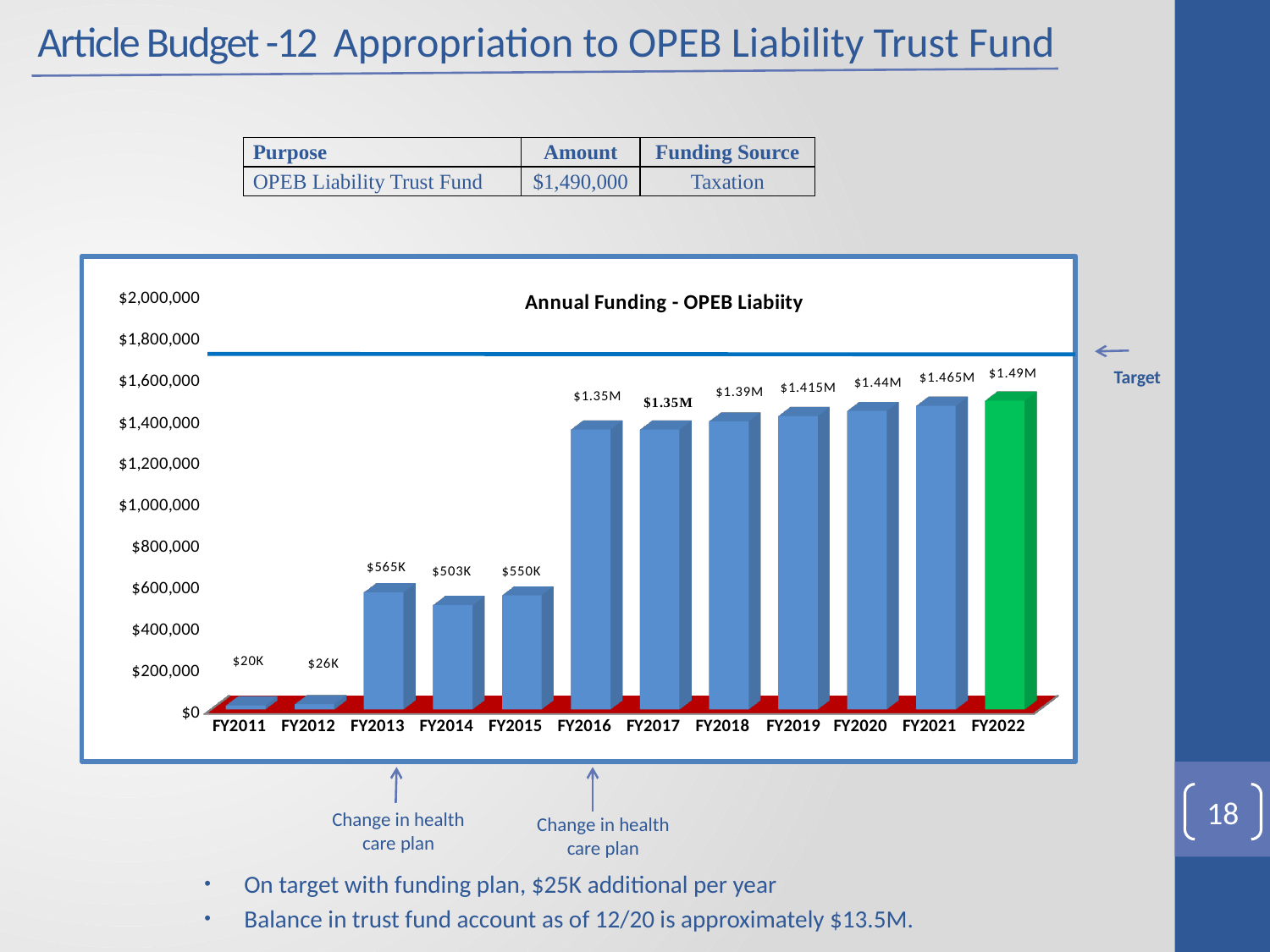
Which fiscal year has the highest value in the Annual Funding - OPEB Liabiity chart? FY2022 How many fiscal years are shown on the x axis of the Annual Funding - OPEB Liabiity chart? 12 What is the value for FY2013 in the Annual Funding - OPEB Liabiity chart? $565K Which fiscal year has the lowest value in the Annual Funding - OPEB Liabiity chart? FY2011 What is the value for FY2011 in the Annual Funding - OPEB Liabiity chart? $20K Is the value for FY2016 in the Annual Funding - OPEB Liabiity chart greater or less than $1,200,000? greater What is the difference between the FY2015 and FY2014 values in the Annual Funding - OPEB Liabiity chart? $47K Do the values in the Annual Funding - OPEB Liabiity chart generally rise or fall from FY2011 to FY2022? rise What kind of chart is the Annual Funding - OPEB Liabiity chart? bar chart Which is larger in the Annual Funding - OPEB Liabiity chart, the value for FY2013 or FY2014? FY2013 What is the value for FY2019 in the Annual Funding - OPEB Liabiity chart? $1.415M What is the difference between the FY2013 and FY2014 values in the Annual Funding - OPEB Liabiity chart? $62K